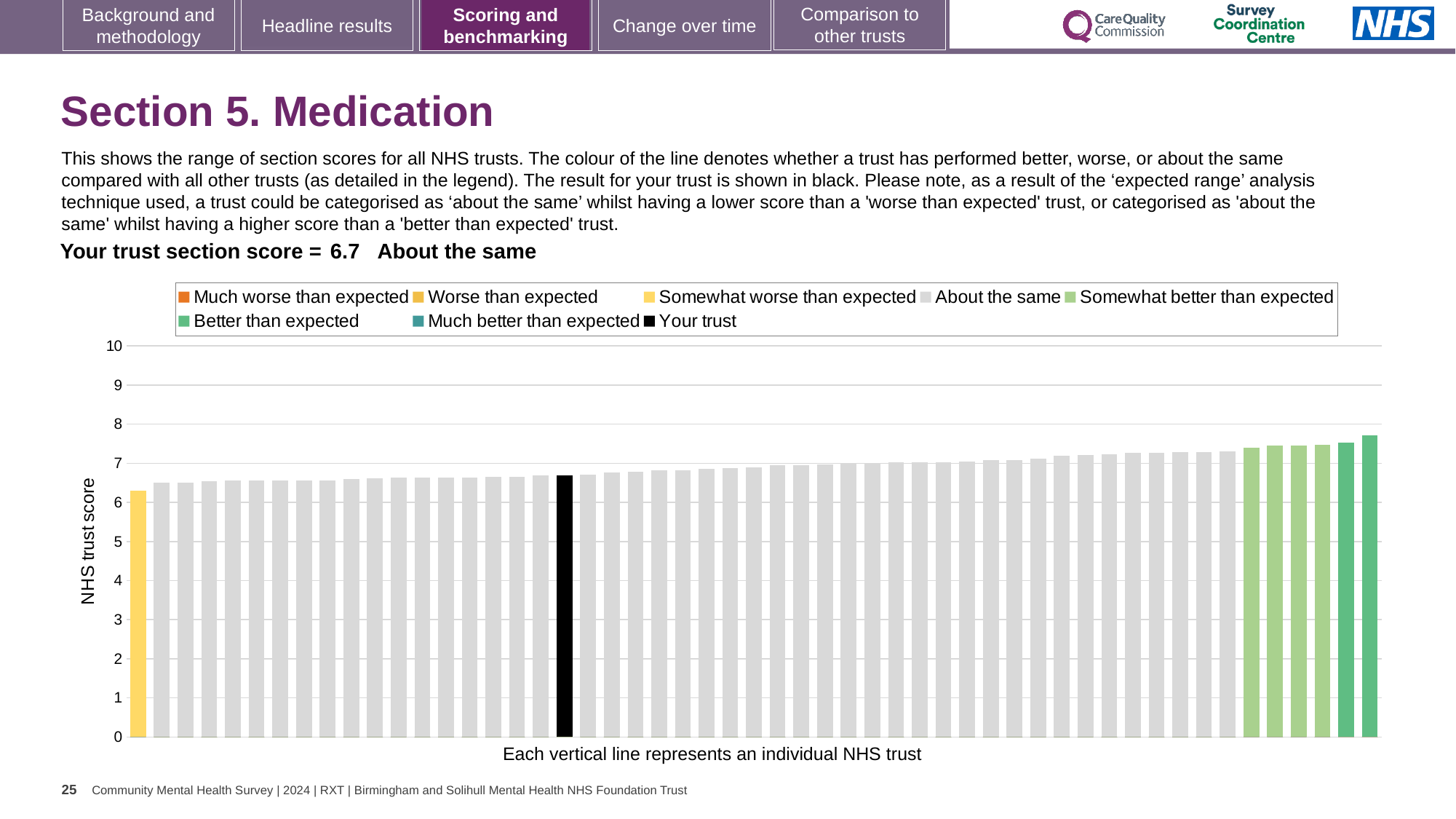
Is the value for your trust (the black bar) greater or less than 7? less What kind of chart is shown on the slide? bar chart Which legend category does the highest-scoring trust (rightmost bar) belong to? Better than expected Which legend category does the lowest-scoring trust (leftmost bar) belong to? Somewhat worse than expected Is the value of the rightmost bar greater or less than 8? less Do the bar values rise or fall from left to right along the x axis? rise Is the value for your trust (the black bar) greater or less than 6? greater How many bars are coloured in the 'Better than expected' shade (the darker green)? 2 How many entries does the chart legend list? 8 What is the label on the vertical axis of the chart? NHS trust score What is your trust's section score for Section 5. Medication? 6.7